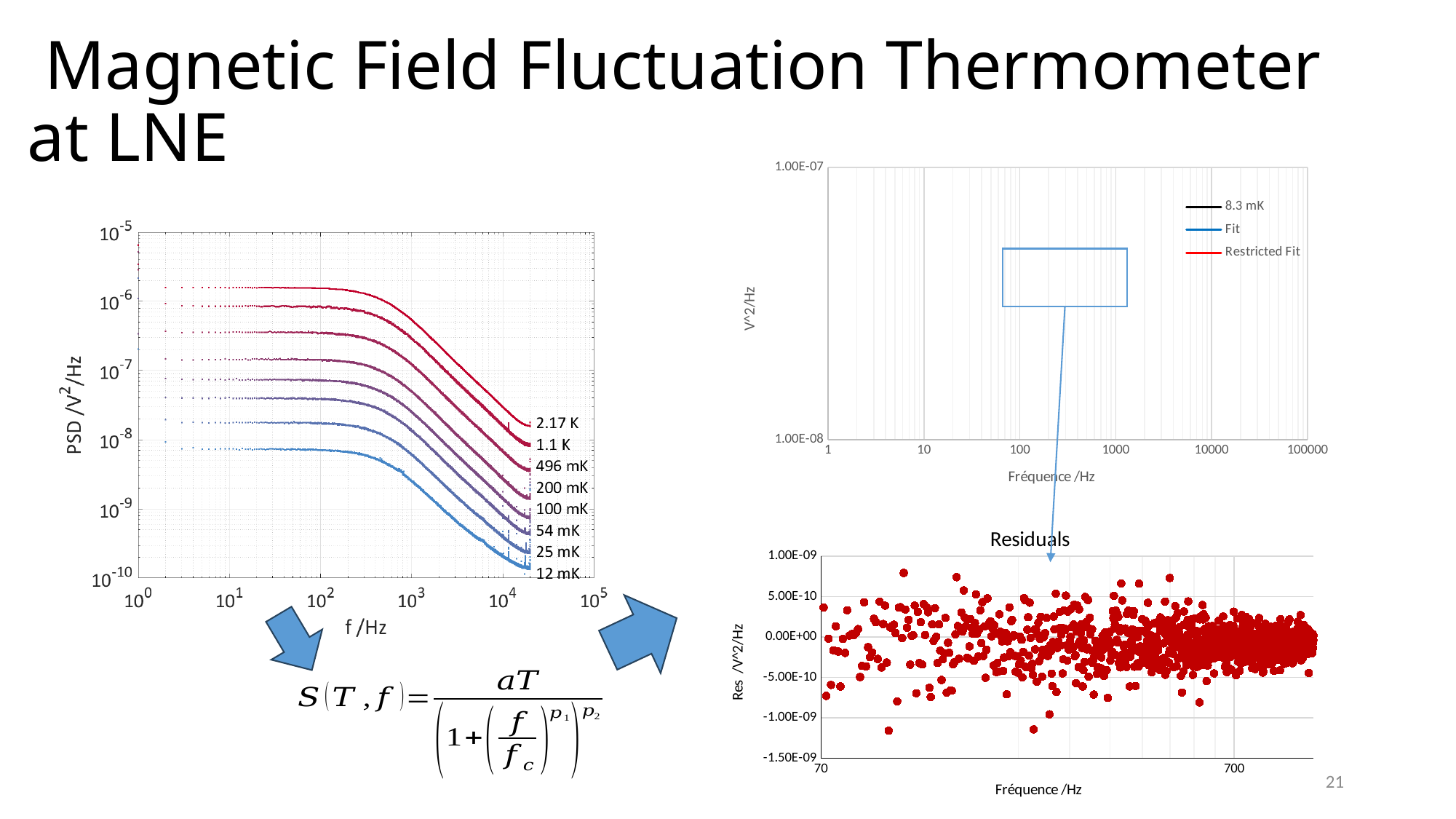
What kind of chart is the bottom-right Residuals chart? scatter chart On the left PSD chart, how many temperature curves are labelled? 8 On the top-right chart, how many series does the legend list? 3 On the left PSD chart, which curve lies higher: 1.1 K or 496 mK? 1.1 K On the left PSD chart, is the low-frequency plateau of the 2.17 K curve greater or less than 10^-6 V²/Hz? greater On the left PSD chart, which temperature curve has the highest PSD values? 2.17 K On the left PSD chart, do the PSD values rise or fall as frequency increases above 10^3 Hz? fall On the left PSD chart, is the low-frequency plateau of the 12 mK curve greater or less than 10^-7 V²/Hz? less On the top-right chart, which legend entry is shown in red? Restricted Fit What is the title of the bottom-right chart? Residuals What kind of chart is the left PSD chart? line chart On the left PSD chart, which temperature curve has the lowest PSD values? 12 mK